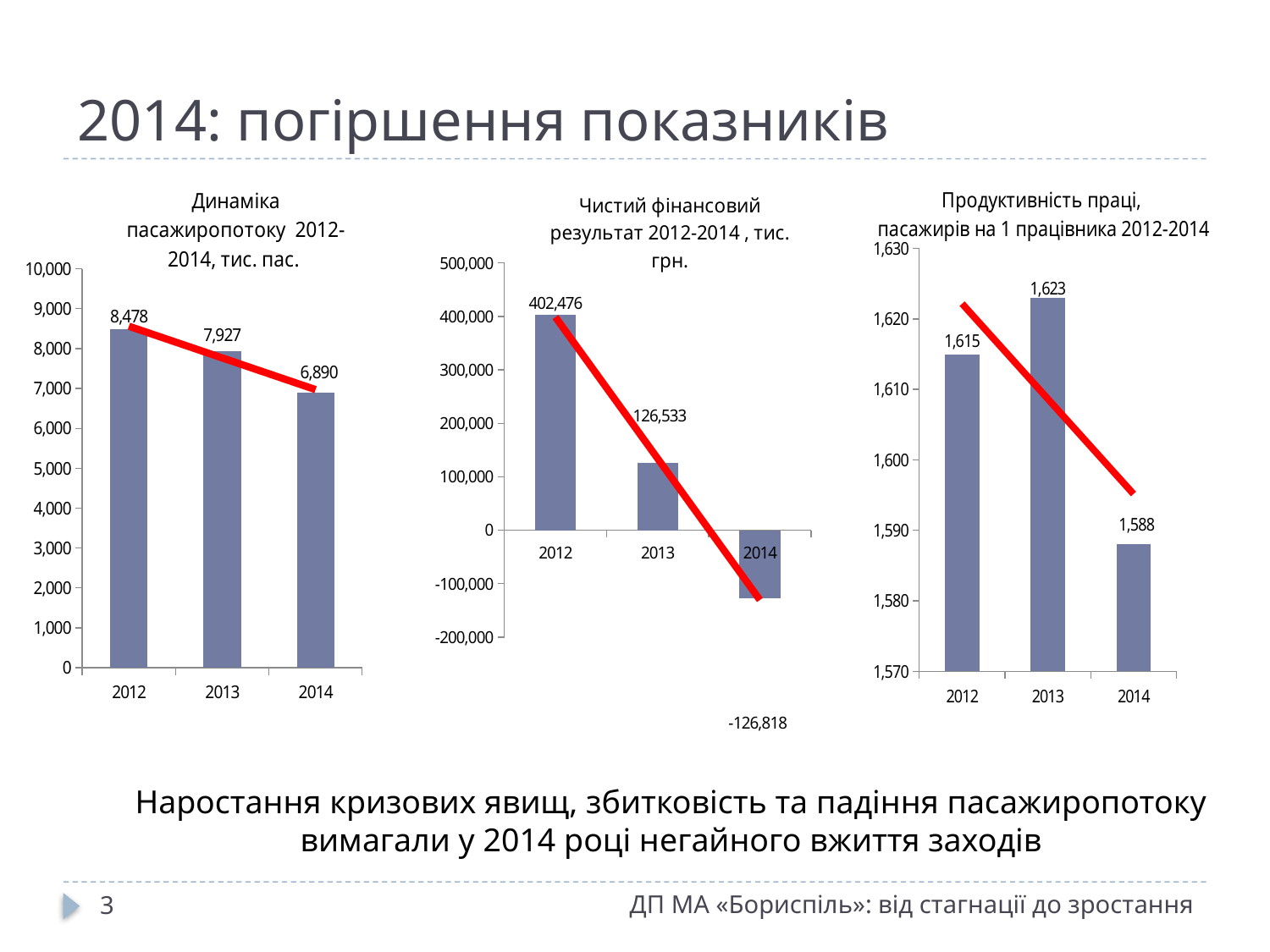
In the middle chart (Чистий фінансовий результат 2012-2014, тис. грн.), what is the value for 2013? 126,533 In the right chart (Продуктивність праці, пасажирів на 1 працівника 2012-2014), is the value for 2012 greater or less than 1,610? greater In the left chart (Динаміка пасажиропотоку 2012-2014, тис. пас.), what is the value for 2012? 8,478 In the right chart (Продуктивність праці, пасажирів на 1 працівника 2012-2014), what is the value for 2013? 1,623 In the left chart (Динаміка пасажиропотоку 2012-2014, тис. пас.), do the values rise or fall from 2012 to 2014? fall In the left chart (Динаміка пасажиропотоку 2012-2014, тис. пас.), which year has the lowest value? 2014 In the middle chart (Чистий фінансовий результат 2012-2014, тис. грн.), what is the difference between the 2012 and 2013 values? 275,943 In the right chart (Продуктивність праці, пасажирів на 1 працівника 2012-2014), which year has the highest value? 2013 In the left chart (Динаміка пасажиропотоку 2012-2014, тис. пас.), what is the difference between the 2012 and 2014 values? 1,588 How many charts are shown on the slide, and what type are they? 3 bar charts In the middle chart (Чистий фінансовий результат 2012-2014, тис. грн.), which year has the highest value? 2012 In the middle chart (Чистий фінансовий результат 2012-2014, тис. грн.), what is the value for 2014? -126,818